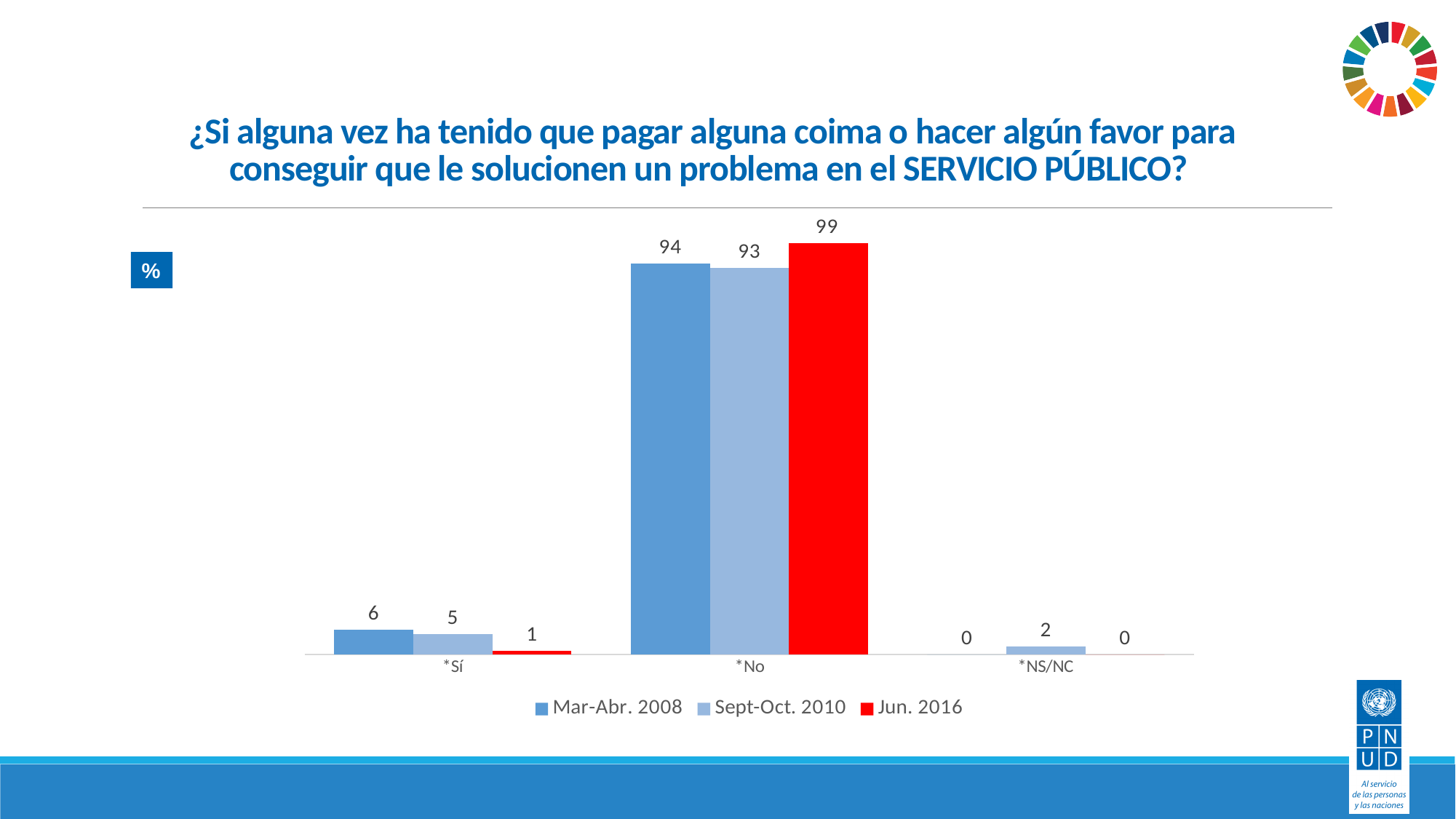
What is the value for *NS/NC in the Sept-Oct. 2010 series? 2 What is the difference between the Jun. 2016 and Mar-Abr. 2008 values for *No? 5 What is the value for *No in the Jun. 2016 series? 99 Which category has the lowest value in the Mar-Abr. 2008 series? *NS/NC Which category has the highest value in the Sept-Oct. 2010 series? *No How many categories are shown on the x axis? 3 Which colour represents the Jun. 2016 series? Red What is the value for *Sí in the Jun. 2016 series? 1 How many series does the legend list? 3 What is the value for *Sí in the Mar-Abr. 2008 series? 6 What kind of chart is shown on the slide? Bar chart Which is larger for *Sí: the Mar-Abr. 2008 value or the Sept-Oct. 2010 value? Mar-Abr. 2008